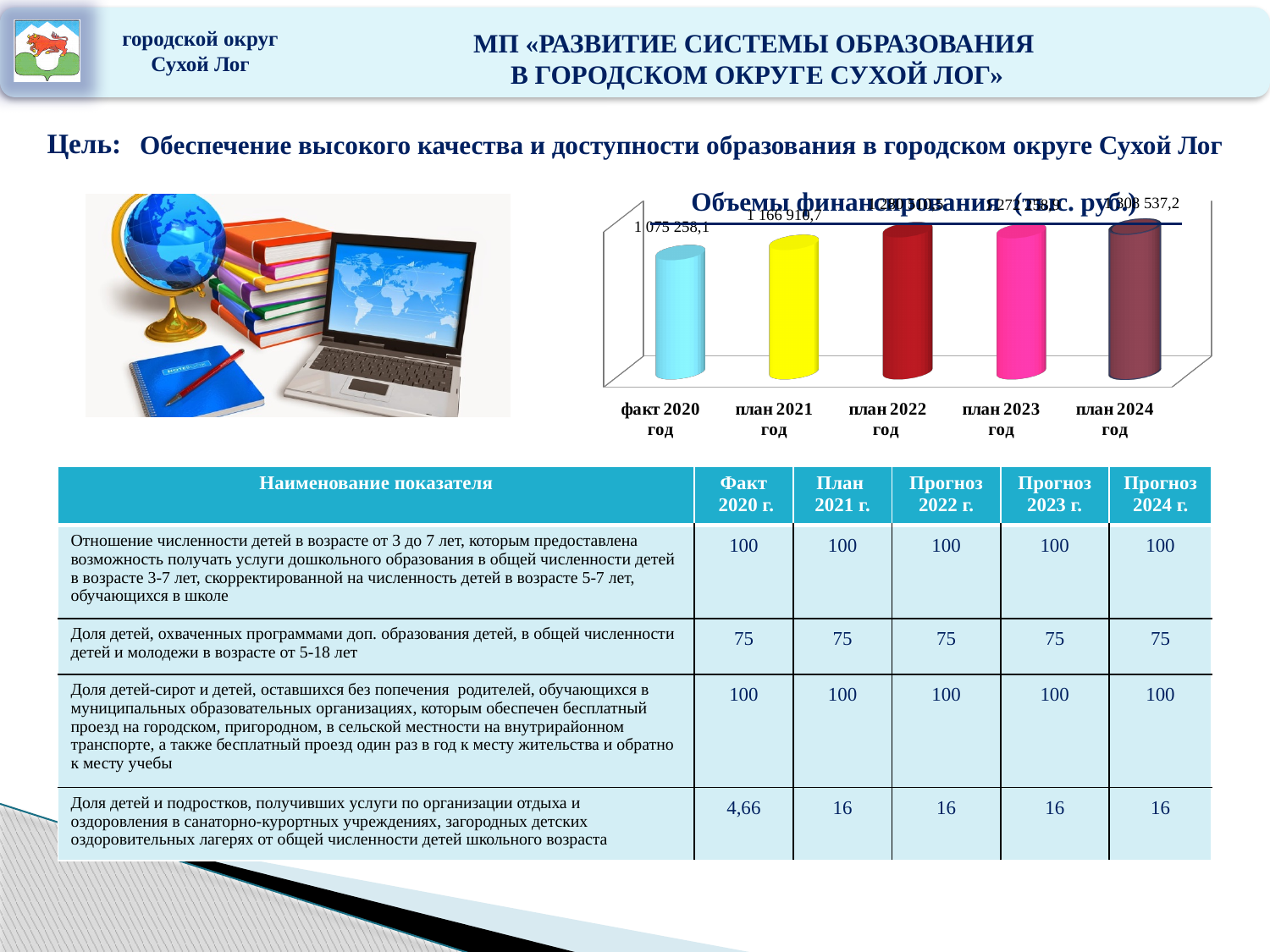
Do the values rise or fall from факт 2020 год to план 2024 год? rise Which is larger, the value for факт 2020 год or план 2021 год? план 2021 год Which category has the highest value in the chart? план 2024 год What is the label of the first category on the x axis of the chart? факт 2020 год How many categories (years) are plotted in the chart? 5 Which category has the lowest value in the chart? факт 2020 год What is the title of the chart? Объемы финансирования (тыс. руб.) What is the value for план 2021 год in the chart? 1 166 910,7 What is the value for факт 2020 год in the chart? 1 075 258,1 What is the difference between the values for план 2021 год and факт 2020 год? 91 652,6 What kind of chart is shown on the slide? bar chart